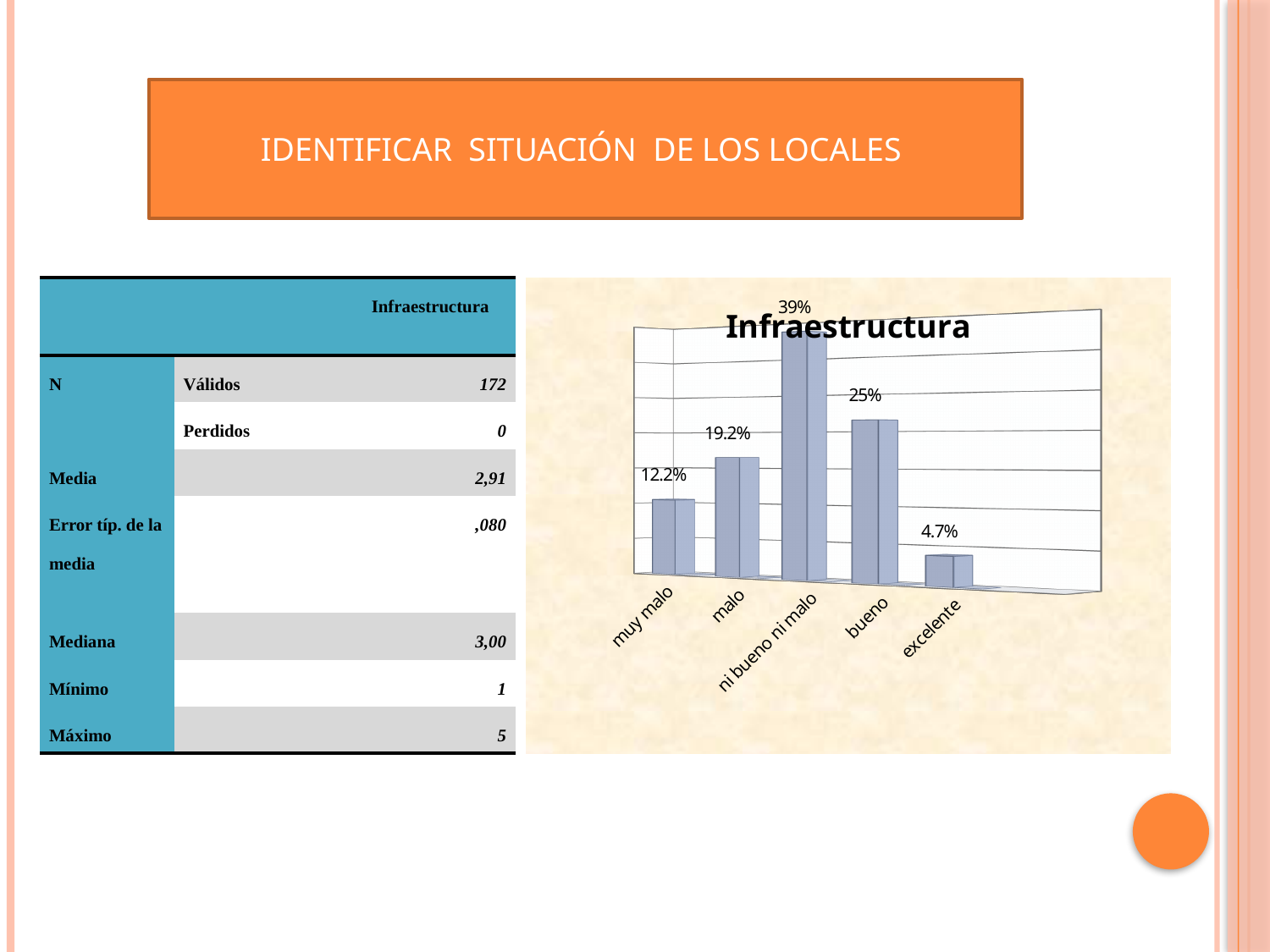
What is the value for 'muy malo' in the Infraestructura chart? 12.2% What is the title of the chart on the slide? Infraestructura What is the difference between the values for 'malo' and 'muy malo' in the Infraestructura chart? 7% Which category has the highest value in the Infraestructura chart? ni bueno ni malo How many categories are shown in the Infraestructura chart? 5 What is the value for 'excelente' in the Infraestructura chart? 4.7% Which category has the lowest value in the Infraestructura chart? excelente What is the value for 'bueno' in the Infraestructura chart? 25% What is the difference between the values for 'ni bueno ni malo' and 'bueno' in the Infraestructura chart? 14% What is the value for 'ni bueno ni malo' in the Infraestructura chart? 39% What kind of chart is the Infraestructura chart? bar chart Which is larger in the Infraestructura chart, the value for 'malo' or the value for 'bueno'? bueno